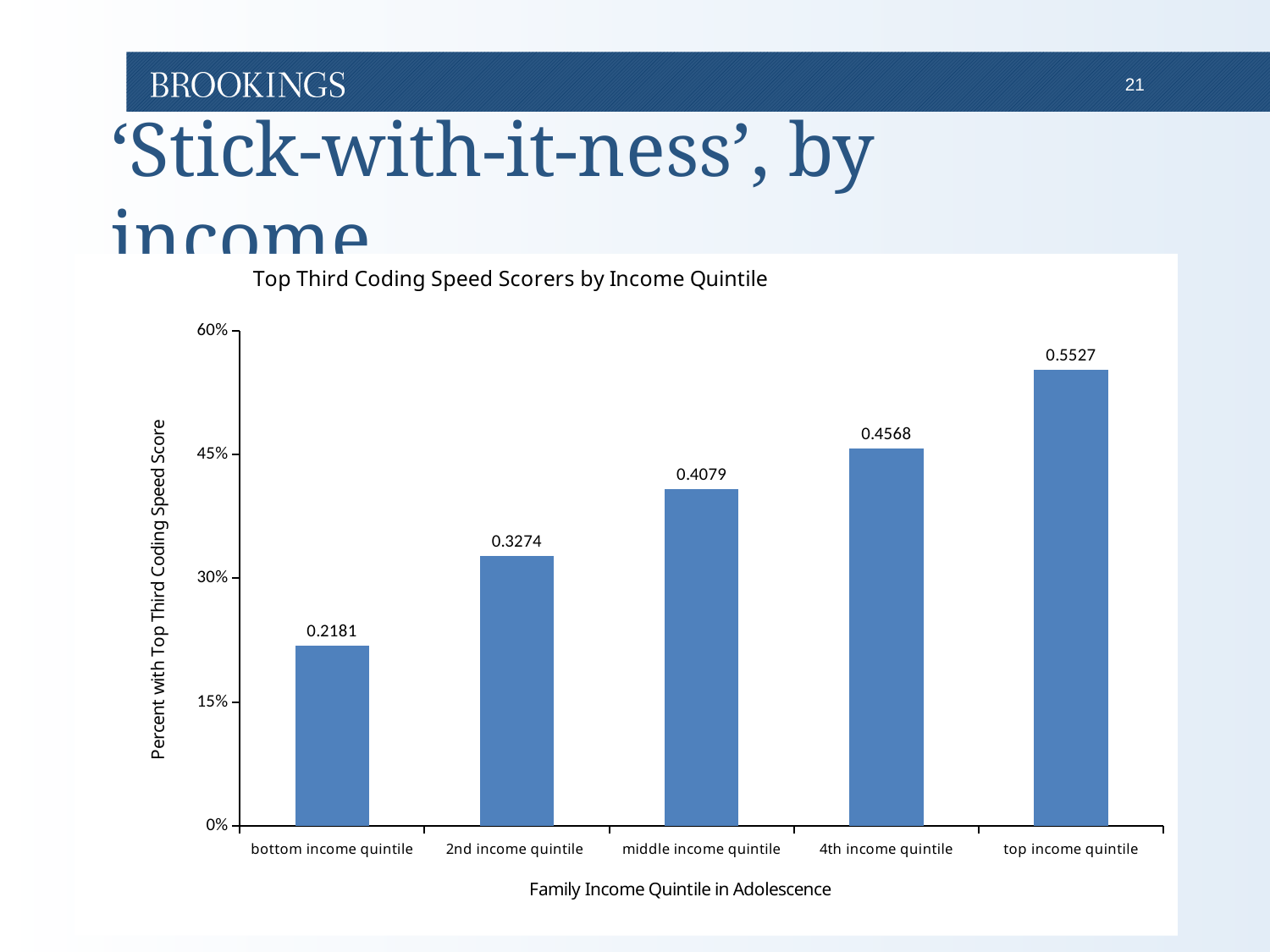
What is the value for the top income quintile? 0.5527 Which income quintile has the highest value? top income quintile What kind of chart is shown on the slide? bar chart What is the difference between the top income quintile and the bottom income quintile values? 0.3346 Is the value for the 4th income quintile greater or less than 45%? greater Which is larger, the value for the 2nd income quintile or the 4th income quintile? 4th income quintile Which income quintile has the lowest value? bottom income quintile Do the values rise or fall from the bottom income quintile to the top income quintile? rise How many income quintile categories are shown on the chart? 5 What is the value for the bottom income quintile? 0.2181 What is the value for the middle income quintile? 0.4079 What is the title of the chart? Top Third Coding Speed Scorers by Income Quintile